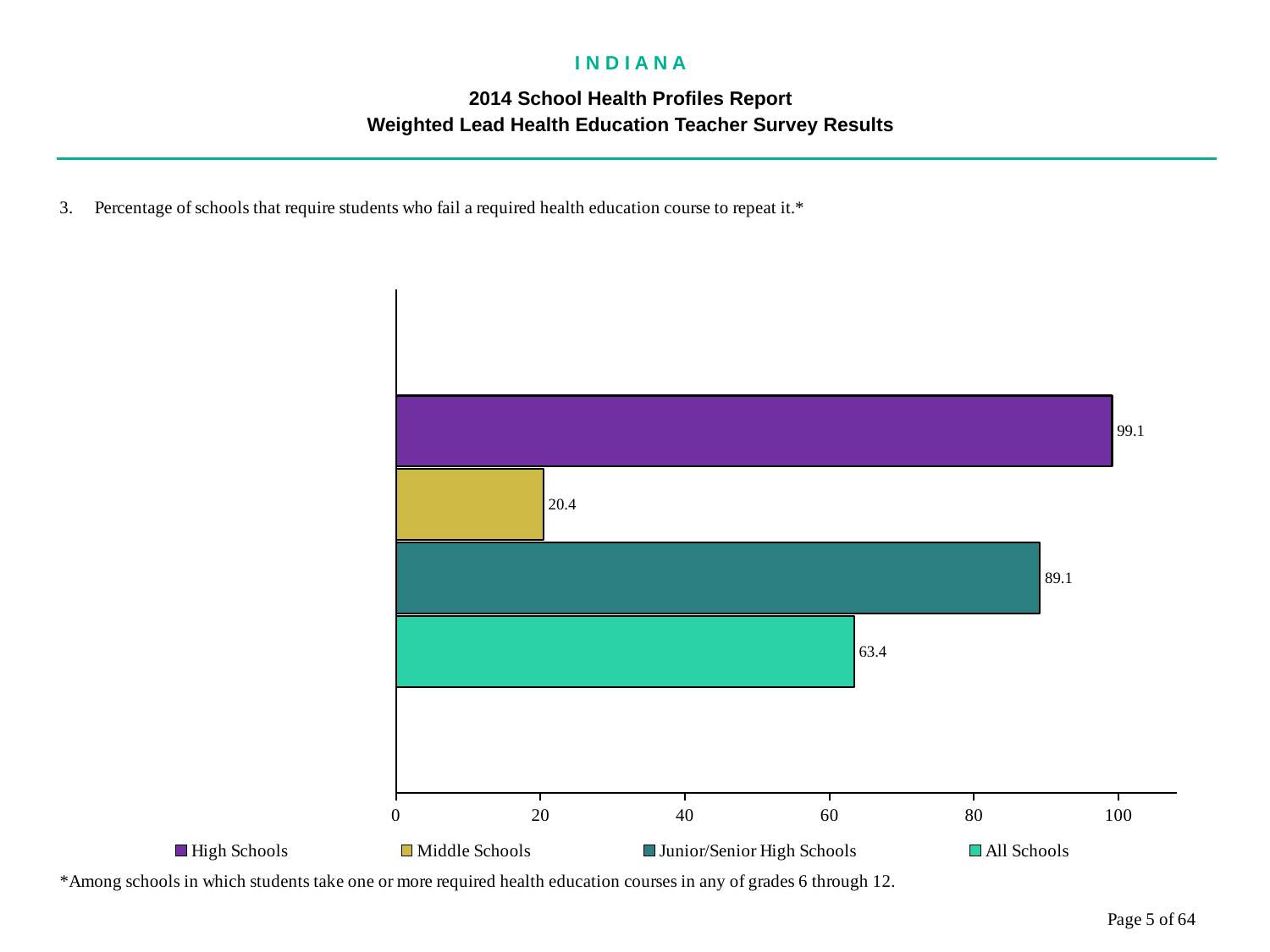
What is the difference between the Junior/Senior High Schools and All Schools values? 25.7 Which is larger, the value for Junior/Senior High Schools or the value for All Schools? Junior/Senior High Schools What kind of chart is shown on the slide? Bar chart How many series does the legend list? 4 What is the difference between the High Schools and Middle Schools values? 78.7 What is the value for Junior/Senior High Schools? 89.1 What is the value for Middle Schools? 20.4 Which school type has the highest percentage? High Schools What is the value for All Schools? 63.4 Which school type has the lowest percentage? Middle Schools What is the value for High Schools? 99.1 Is the value for All Schools greater or less than 60? greater